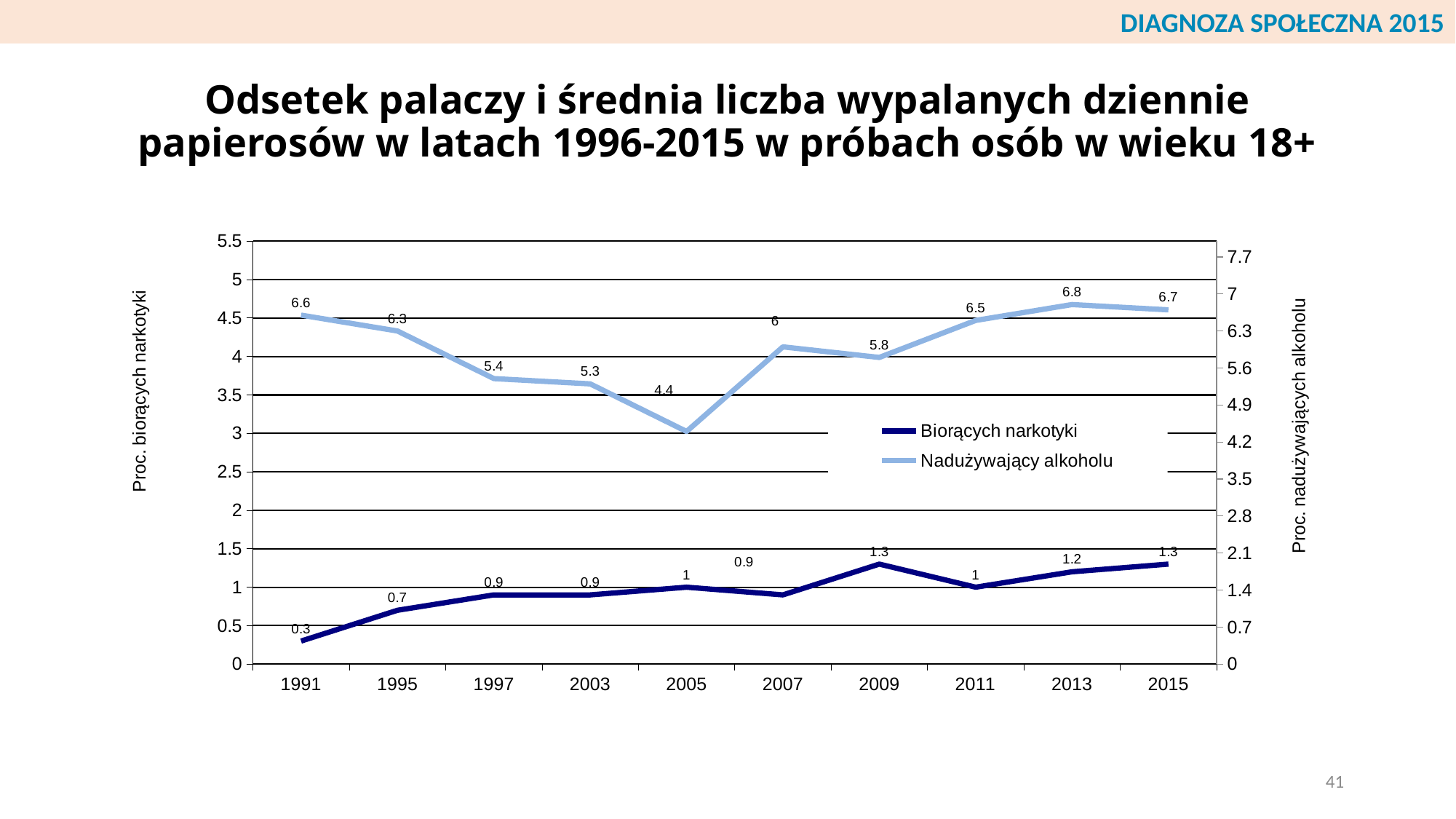
What is the value for Nadużywający alkoholu in 2005? 4.4 In which year is the value for Biorących narkotyki lowest? 1991 What kind of chart is shown on the slide? line chart What is the value for Nadużywający alkoholu in 2013? 6.8 In which year is the value for Nadużywający alkoholu lowest? 2005 What is the difference between the Nadużywający alkoholu values in 1991 and 2005? 2.2 In which year is the value for Nadużywający alkoholu highest? 2013 How many years are shown on the x axis? 10 Which is larger for Nadużywający alkoholu: the value in 2007 or the value in 2009? 2007 What is the value for Biorących narkotyki in 1991? 0.3 How many series does the legend list? 2 What is the value for Biorących narkotyki in 2009? 1.3